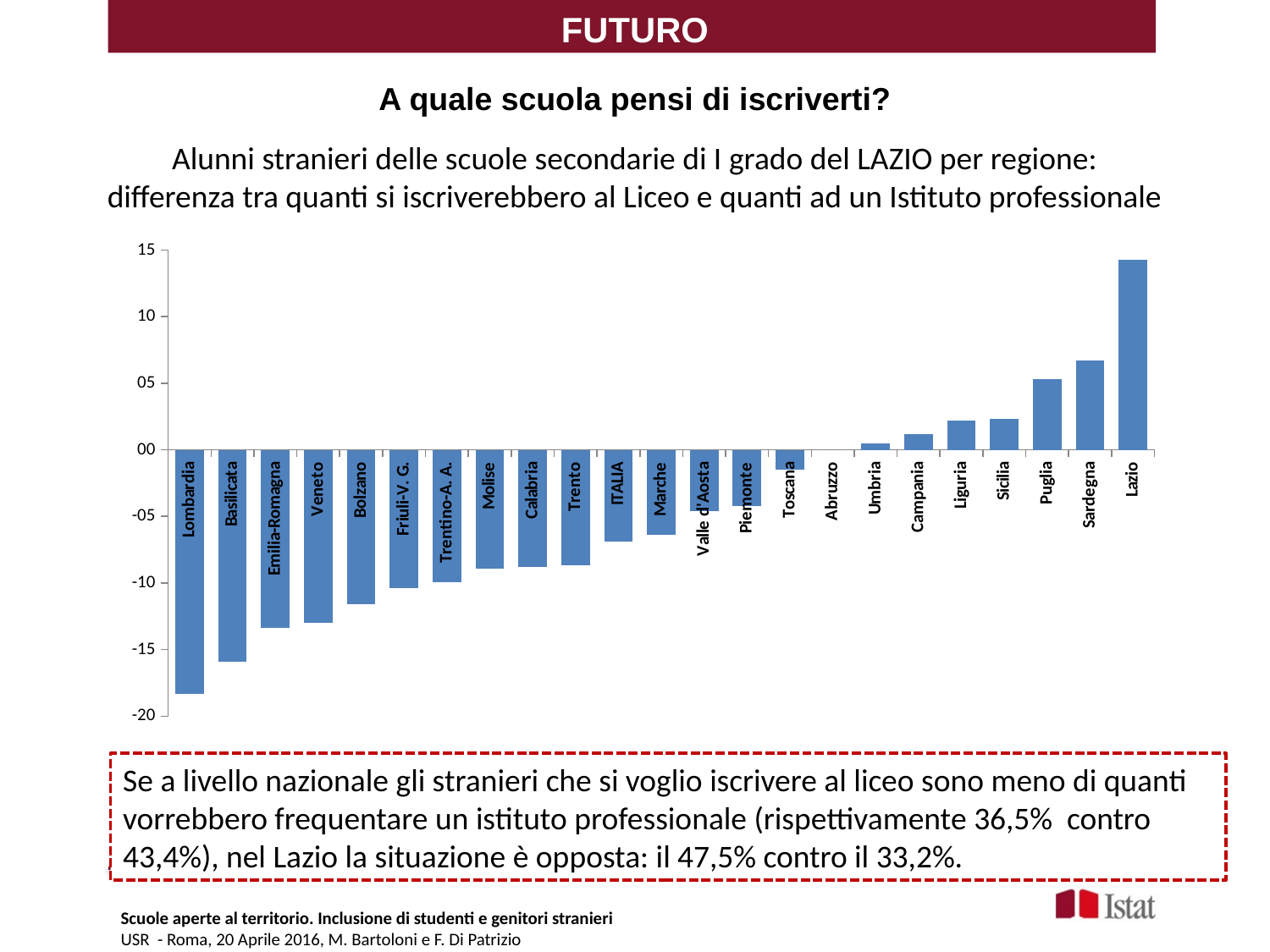
Which has the larger value, Puglia or Campania? Puglia Do the values rise or fall moving from left to right along the x axis? rise Is the value for ITALIA greater or less than -5? less What is the question posed in the heading above the chart? A quale scuola pensi di iscriverti? Which region has the highest value in the chart? Lazio Which region has the lowest value in the chart? Lombardia Is the value for Lazio greater or less than 10? greater How many categories (bars) are shown on the x axis of the chart? 23 Is the value for Lombardia greater or less than -15? less What kind of chart is shown on the slide? bar chart